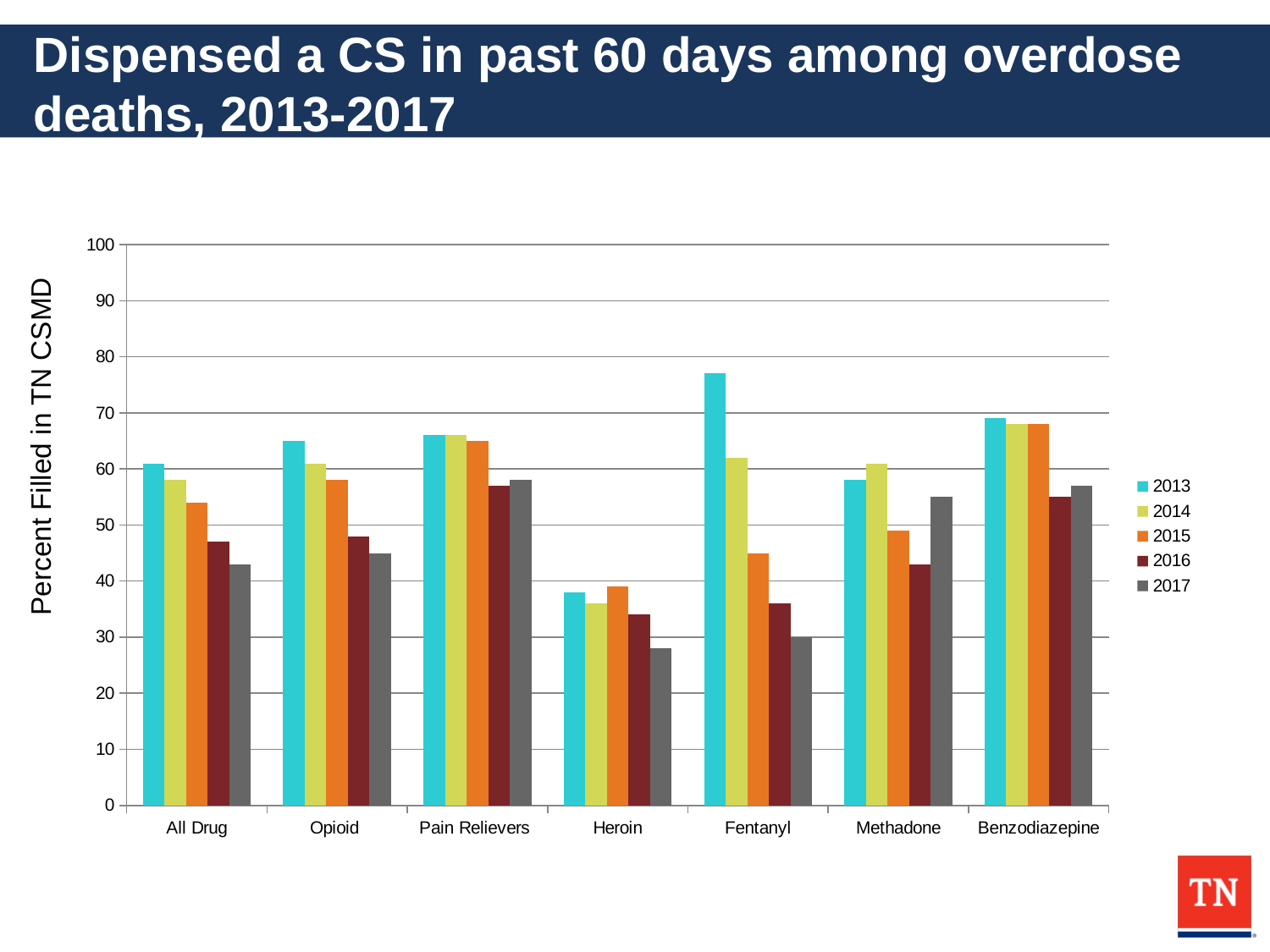
For Heroin, which year has the lowest value? 2017 What is the label of the y axis? Percent Filled in TN CSMD Which is larger for Methadone, the 2016 value or the 2017 value? 2017 Do the values for Opioid rise or fall from 2013 to 2017? fall What kind of chart is shown on the slide? bar chart How many series does the legend list? 5 For Fentanyl, which year has the highest value? 2013 Is the 2017 value for Heroin greater or less than 40? less How many categories are shown along the x axis? 7 Which category has the lowest 2013 value? Heroin Which category has the tallest bar in the chart? Fentanyl Is the 2013 value for Fentanyl greater or less than 70? greater